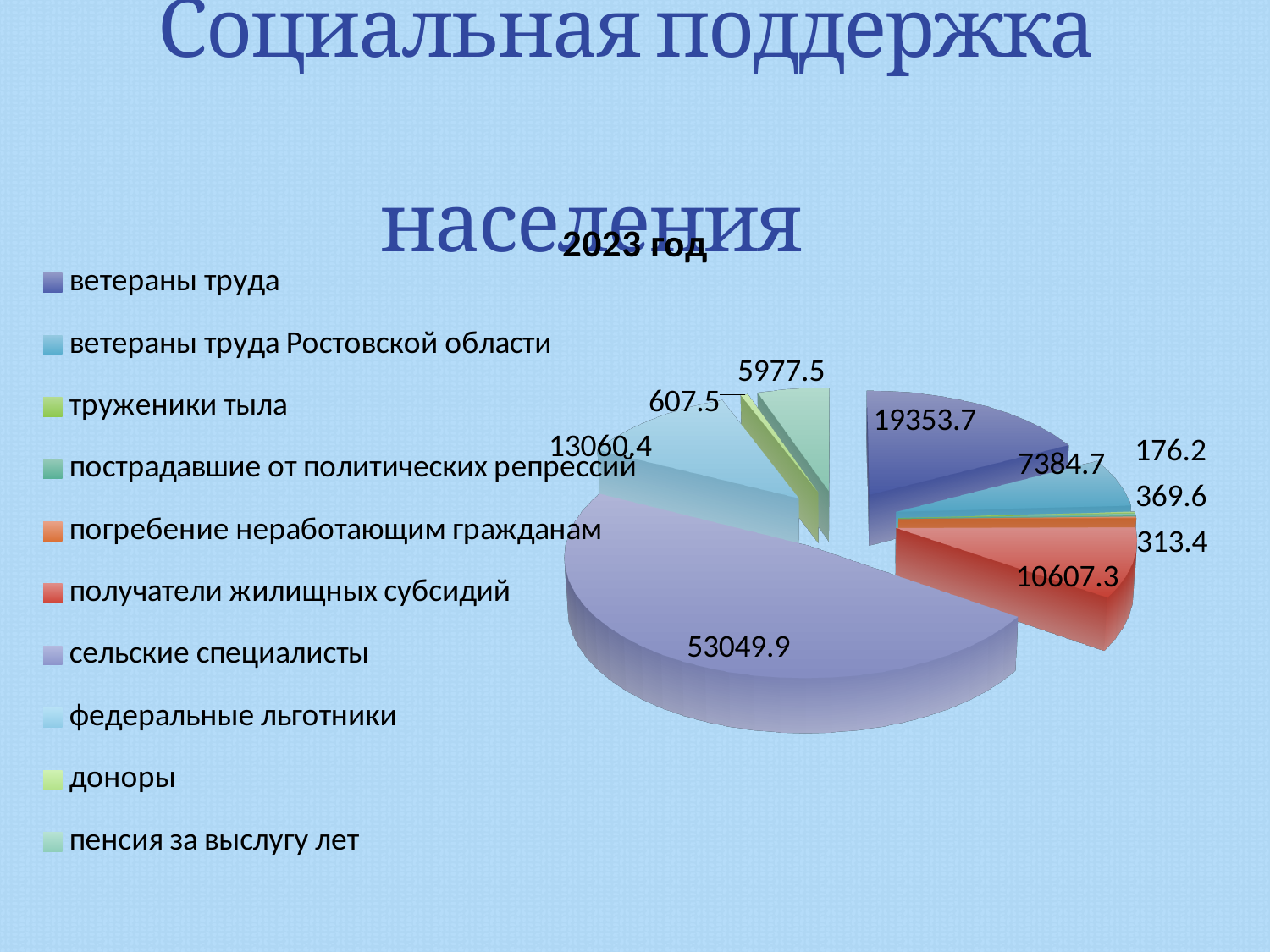
What is the value for получатели жилищных субсидий? 10607.3 Which is larger, ветераны труда or федеральные льготники? ветераны труда What is the title of the chart? 2023 год Which category has the largest slice of the pie? сельские специалисты What is the difference between the values for ветераны труда and федеральные льготники? 6293.3 What is the value for пенсия за выслугу лет? 5977.5 What is the value for федеральные льготники? 13060.4 What is the difference between the values for сельские специалисты and ветераны труда? 33696.2 What kind of chart is shown on the slide? pie chart How many categories does the legend of the pie chart list? 10 What is the value for сельские специалисты? 53049.9 What is the value for ветераны труда? 19353.7